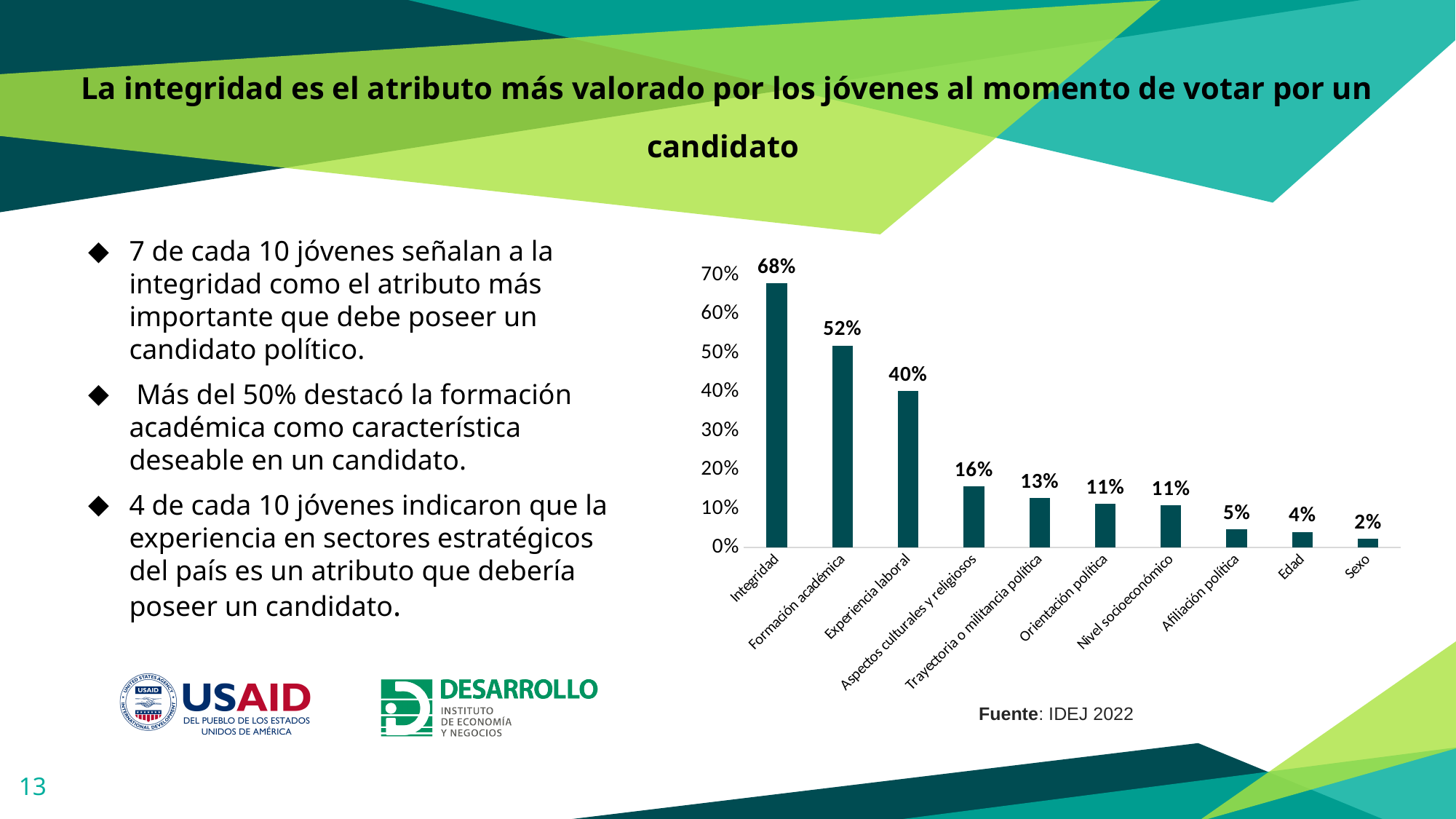
Do the values rise or fall from left to right along the x axis? Fall Which category has the highest value? Integridad What is the value for Aspectos culturales y religiosos? 16% Which is larger, the value for Trayectoria o militancia política or the value for Afiliación política? Trayectoria o militancia política What is the value for Integridad? 68% What kind of chart is shown on the slide? Bar chart What is the difference between the values for Integridad and Formación académica? 16% What is the value for Experiencia laboral? 40% What is the value for Sexo? 2% What is the value for Formación académica? 52% Which category has the lowest value? Sexo How many categories are shown in the chart? 10